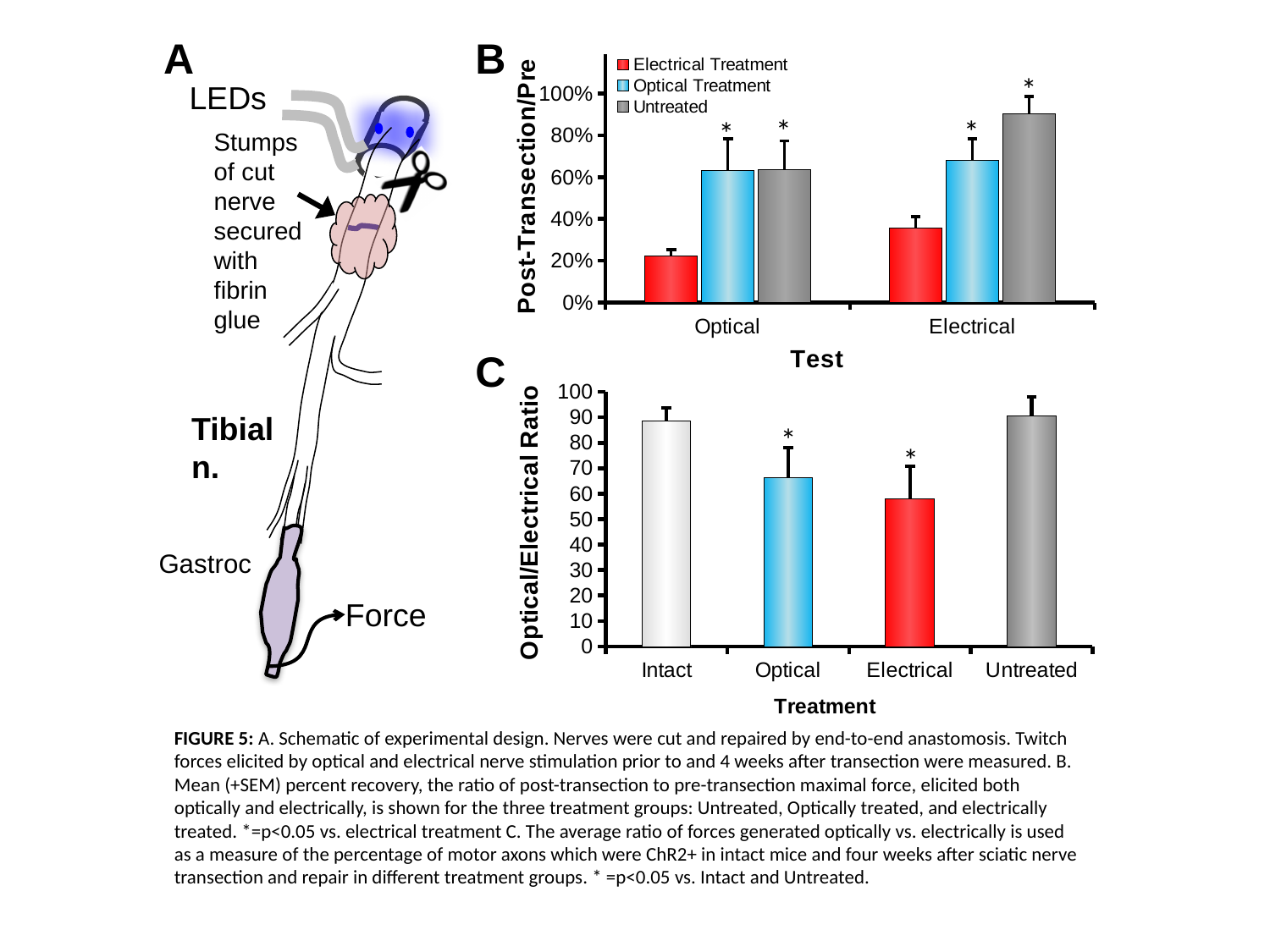
In chart B (Post-Transection/Pre), which is larger: Optical Treatment in the Optical test or Electrical Treatment in the Optical test? Optical Treatment In chart C (Optical/Electrical Ratio), is the value for Intact greater or less than 80? greater In chart B (Post-Transection/Pre), what kind of chart is shown? bar chart In chart C (Optical/Electrical Ratio), how many treatment categories are shown on the x axis? 4 In chart B (Post-Transection/Pre), which series has the highest value in the Electrical test? Untreated In chart C (Optical/Electrical Ratio), what is the label of the x axis? Treatment In chart B (Post-Transection/Pre), is the value for Electrical Treatment in the Optical test greater or less than 40%? less In chart B (Post-Transection/Pre), which series has the lowest value in the Electrical test? Electrical Treatment In chart B (Post-Transection/Pre), how many series does the legend list? 3 In chart B (Post-Transection/Pre), is the value for Untreated in the Electrical test greater or less than 80%? greater In chart C (Optical/Electrical Ratio), which treatment has the lowest value? Electrical